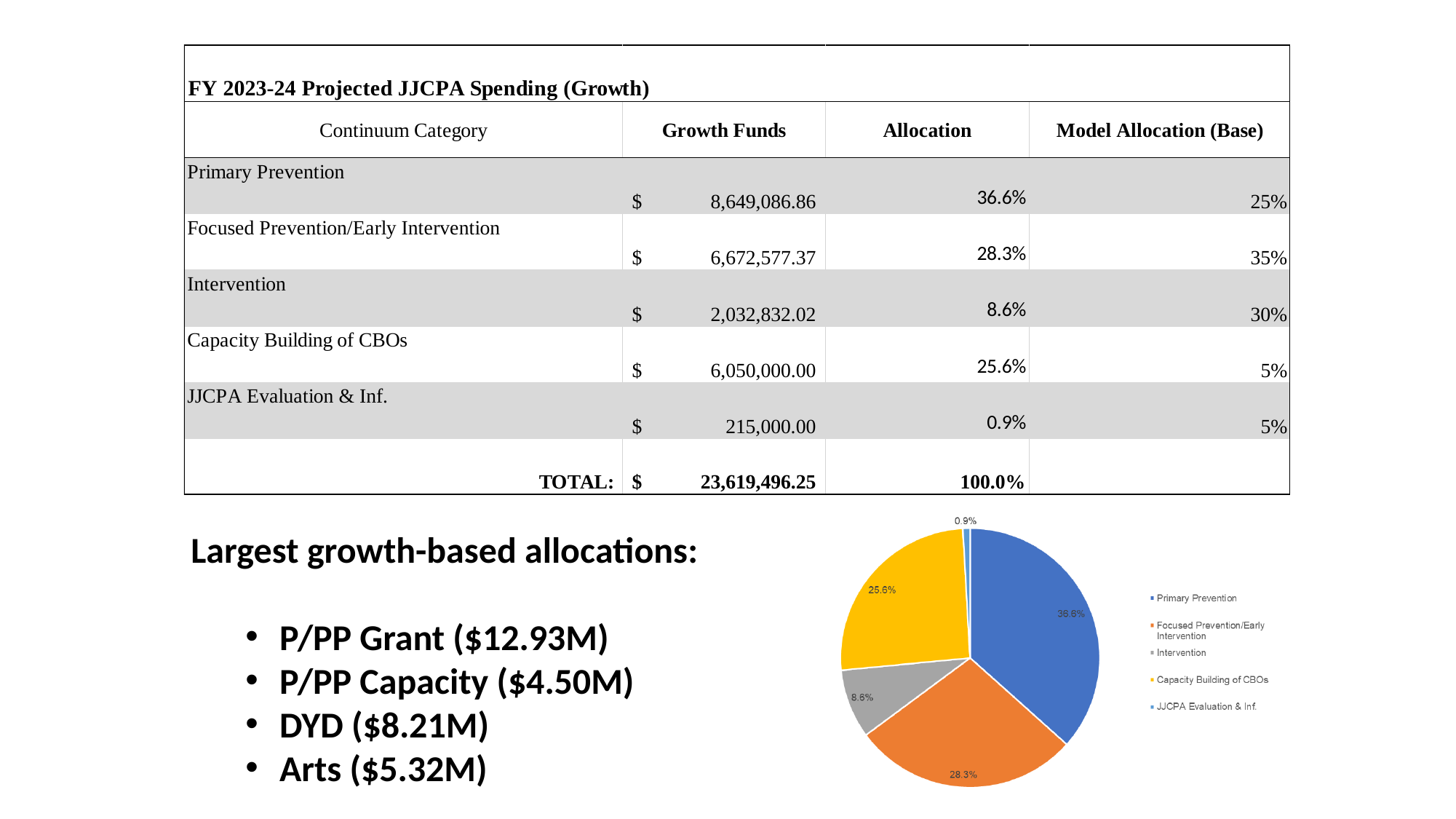
Which category has the smallest slice in the pie chart? JJCPA Evaluation & Inf. What share of the pie chart does Focused Prevention/Early Intervention represent? 28.3% What share of the pie chart does Intervention represent? 8.6% What share of the pie chart does JJCPA Evaluation & Inf. represent? 0.9% How many categories does the pie chart legend list? 5 What colour is the Capacity Building of CBOs slice in the pie chart? yellow What kind of chart is shown on the slide? pie chart Which category has the largest slice in the pie chart? Primary Prevention What is the difference in percentage points between the Primary Prevention slice and the Focused Prevention/Early Intervention slice? 8.3 Which slice is larger in the pie chart: Capacity Building of CBOs or Intervention? Capacity Building of CBOs